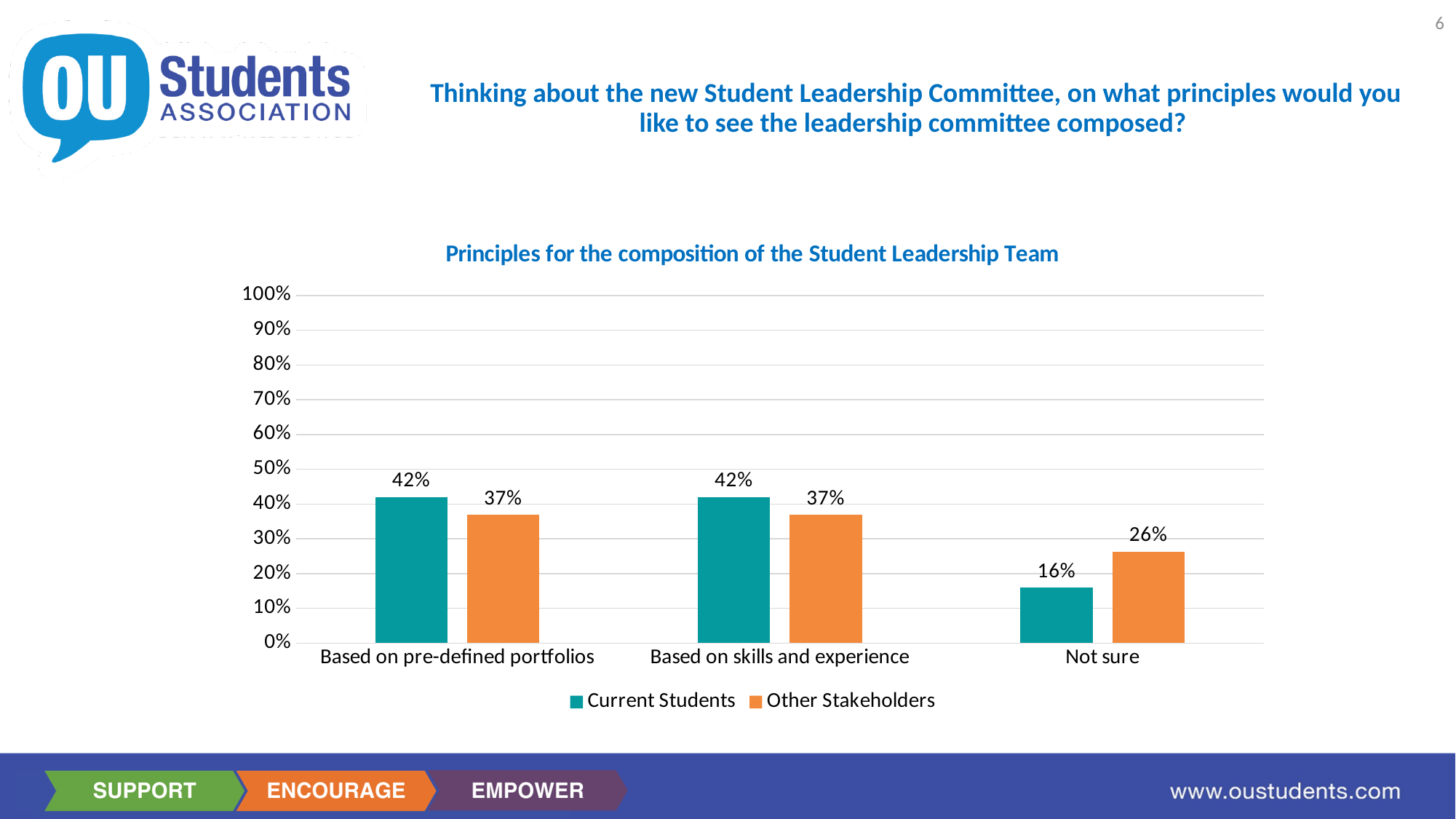
How many categories are shown on the x axis? 3 Which category has the lowest value for Current Students? Not sure How many series does the legend list? 2 What is the difference between Current Students and Other Stakeholders for 'Based on pre-defined portfolios'? 5% What is the value for Other Stakeholders for 'Based on skills and experience'? 37% What is the value for Other Stakeholders for 'Not sure'? 26% What kind of chart is shown on the slide? Bar chart For 'Not sure', which is larger: Current Students or Other Stakeholders? Other Stakeholders What is the value for Current Students for 'Based on pre-defined portfolios'? 42% What is the value for Current Students for 'Not sure'? 16% What is the difference between Other Stakeholders and Current Students for 'Not sure'? 10% Which category has the lowest value for Other Stakeholders? Not sure